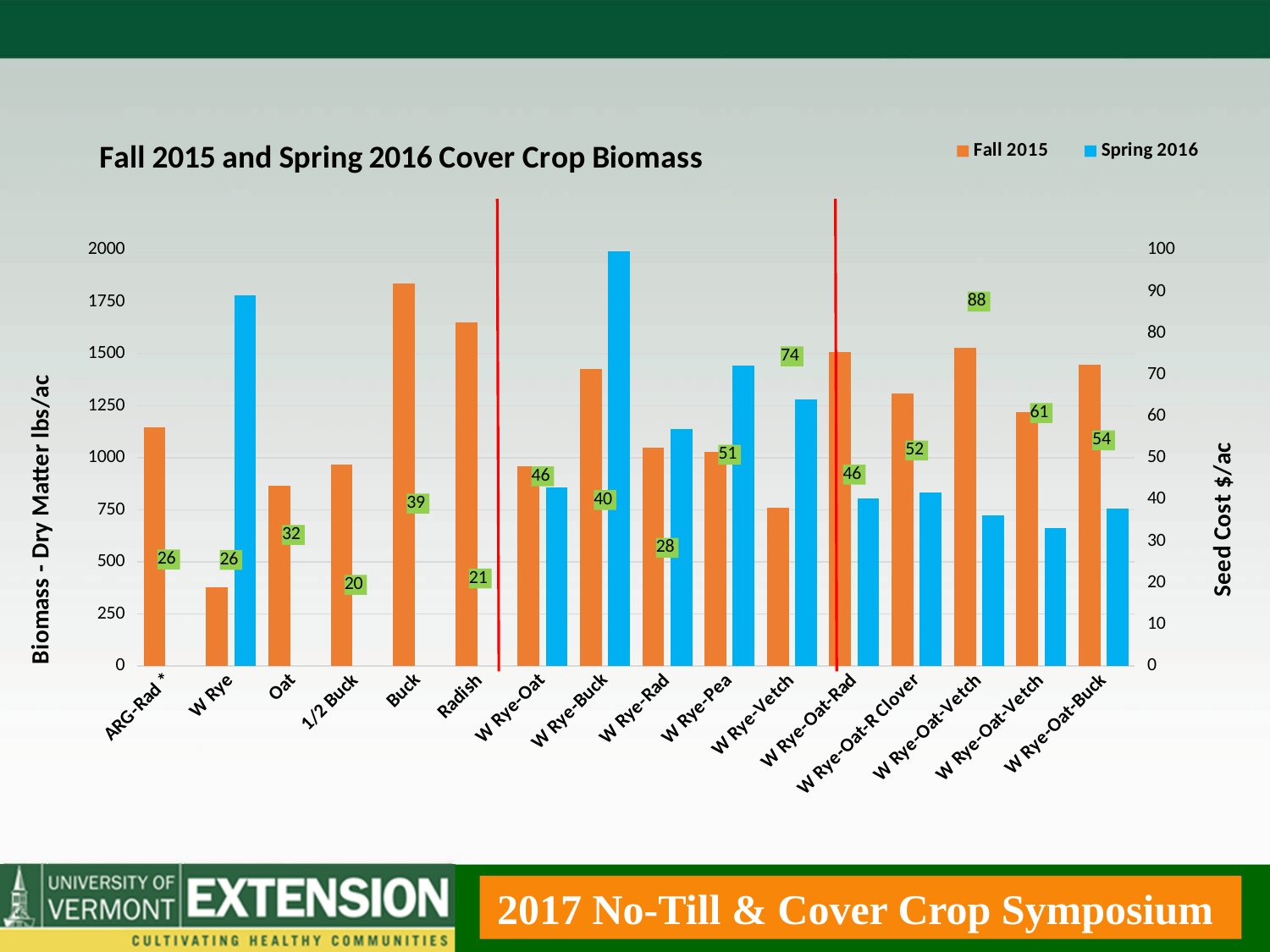
What is the highest seed cost ($/ac) label shown on the chart? 88 How many cover crop categories are shown on the x axis? 16 What seed cost ($/ac) is labelled for 1/2 Buck? 20 What kind of chart is shown on the slide? bar chart Is the Fall 2015 biomass value for Radish greater or less than 1500? greater What seed cost ($/ac) is labelled for W Rye-Vetch? 74 How many series does the legend list? 2 Which category has the tallest Fall 2015 bar? Buck What is the difference between the seed cost labels for W Rye-Vetch and W Rye-Rad? 46 For W Rye, which is larger: the Fall 2015 bar or the Spring 2016 bar? Spring 2016 Which category has the shortest Fall 2015 bar? W Rye Which category has the tallest Spring 2016 bar? W Rye-Buck